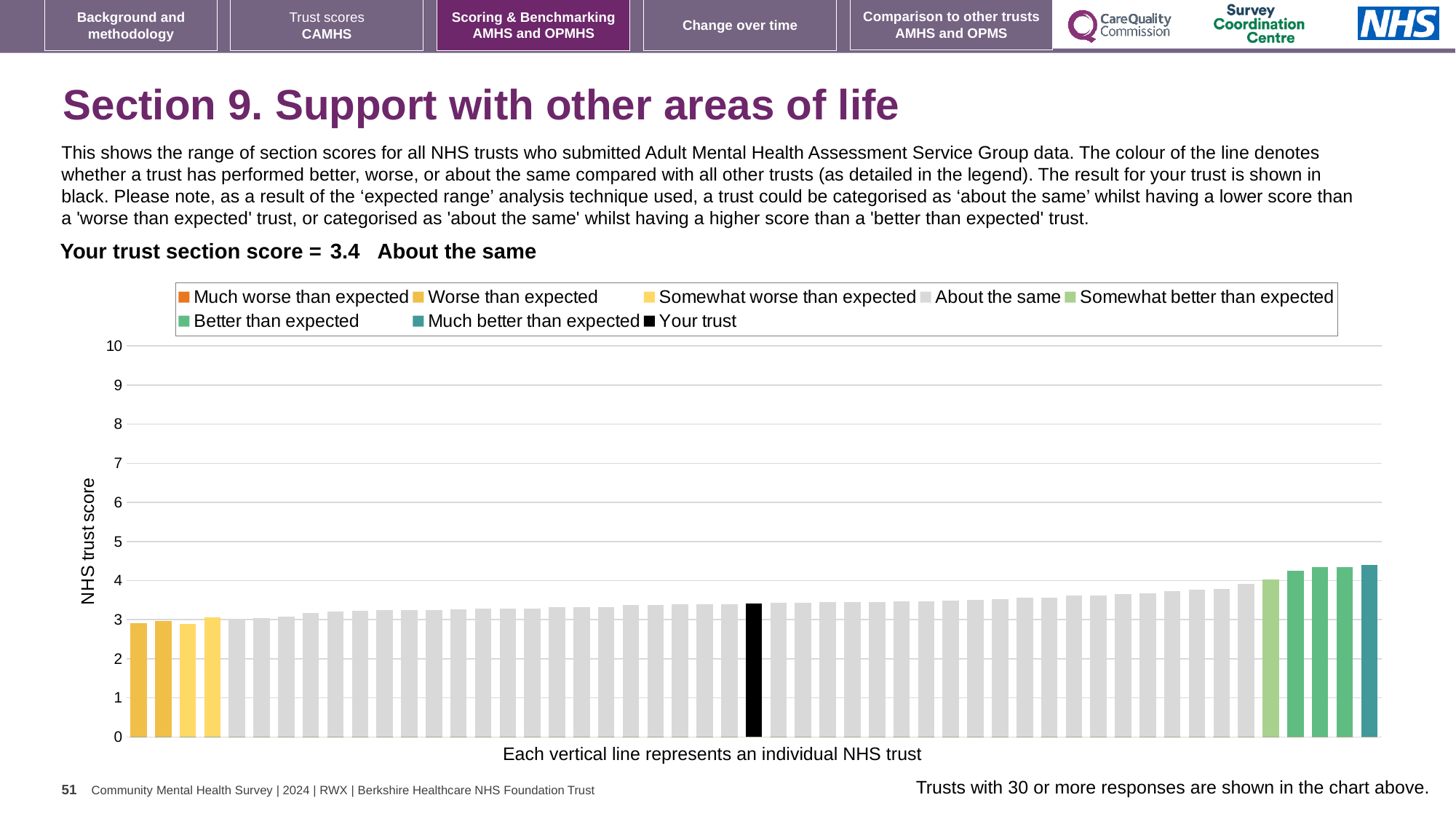
What kind of chart is shown on the slide? bar chart Is the value of the tallest bar in the chart greater or less than 4? greater What is the section score for your trust shown on the slide? 3.4 What colour is the bar representing your trust? black Is the value of the black 'Your trust' bar greater or less than 4? less Do the bar values rise or fall from left to right along the x axis? rise Which category is your trust's section score placed in? About the same What is the label on the vertical axis of the chart? NHS trust score How many entries does the chart legend list? 8 Is the value of the tallest bar in the chart greater or less than 5? less